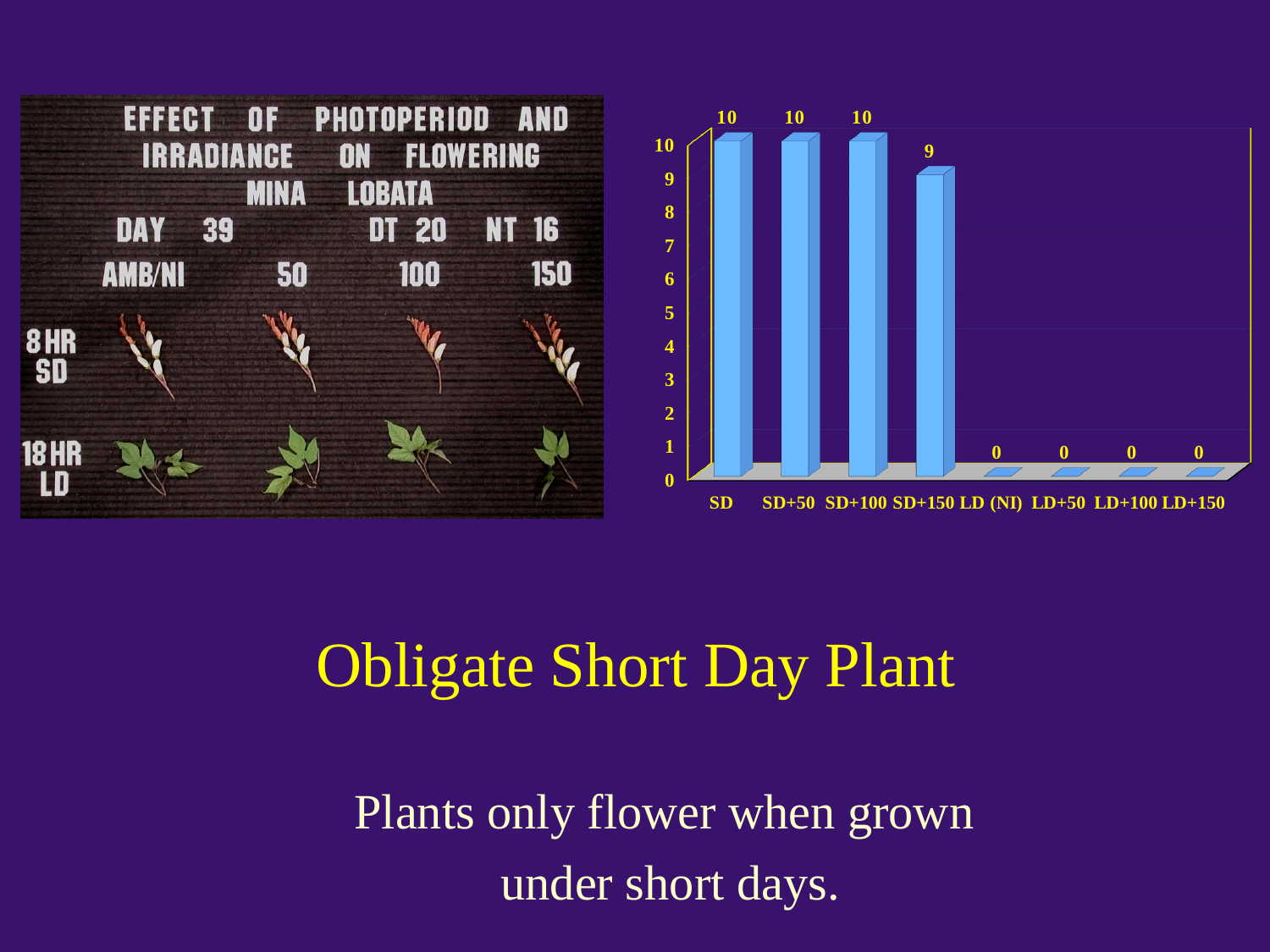
How many categories are shown on the x axis? 8 What kind of chart is this? bar chart How many categories have a value of 0? 4 Which is larger, the value for SD+100 or the value for LD+50? SD+100 What is the highest value shown on the y axis? 10 What is the value for LD+100? 0 What is the value for SD+50? 10 Do the values rise or fall from SD+100 to LD (NI)? fall What is the difference between the values for SD and SD+150? 1 Which category has the lowest non-zero value? SD+150 Is the value for SD+150 greater or less than 5? greater What is the value for SD+150? 9